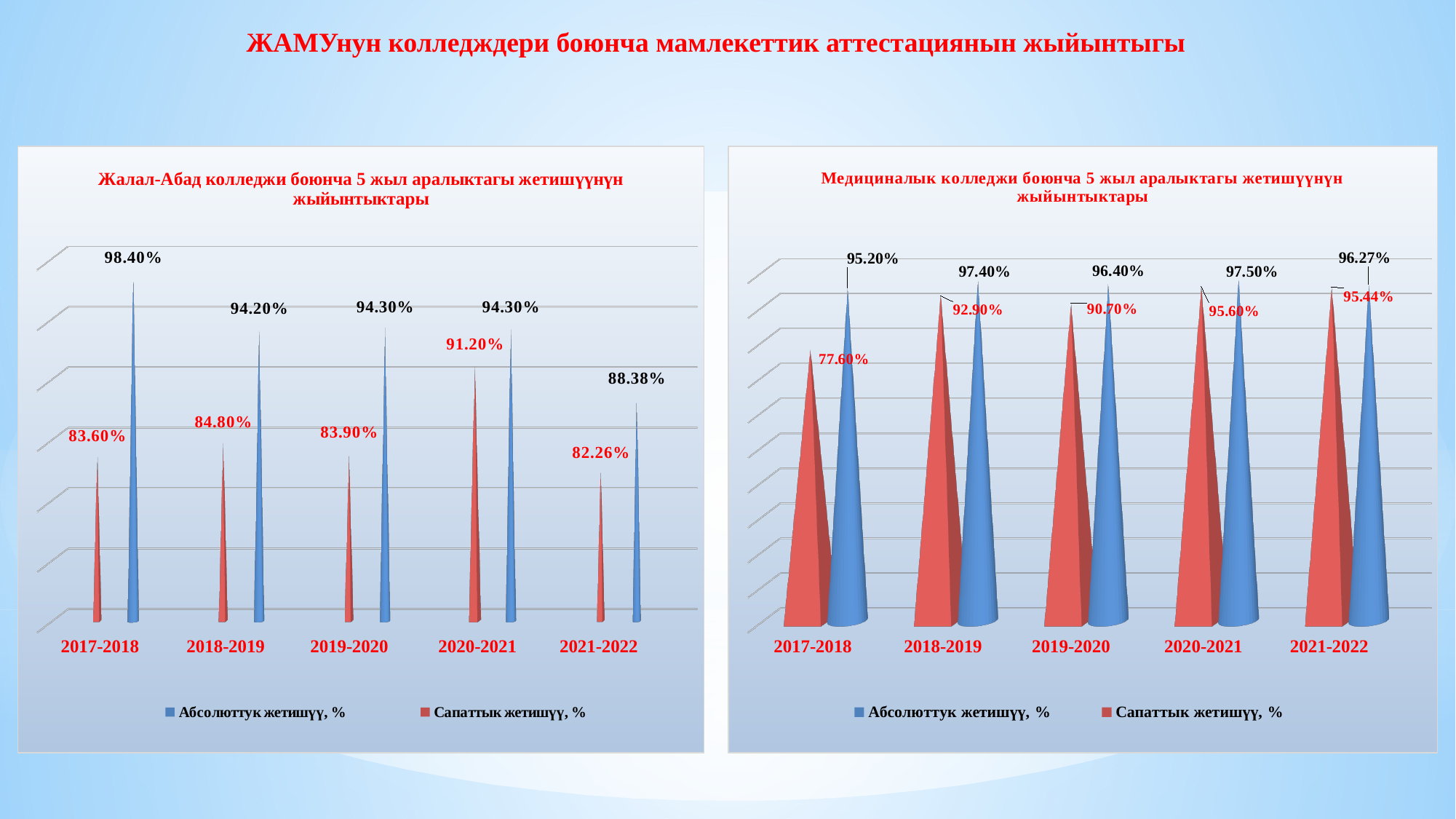
In the left chart (Жалал-Абад колледжи), what is the difference between Абсолюттук жетишүү, % and Сапаттык жетишүү, % for 2017-2018? 14.80% How many series does the legend of the right chart (Медициналык колледжи) list? 2 In the right chart (Медициналык колледжи), which year has the lowest Сапаттык жетишүү, %? 2017-2018 In the left chart (Жалал-Абад колледжи), what is the value of Абсолюттук жетишүү, % for 2017-2018? 98.40% How many year categories are shown on the x axis of the left chart (Жалал-Абад колледжи)? 5 In the right chart (Медициналык колледжи), what is the value of Сапаттык жетишүү, % for 2017-2018? 77.60% In the right chart (Медициналык колледжи), which year has the highest Абсолюттук жетишүү, %? 2020-2021 In the right chart (Медициналык колледжи), which is larger for 2018-2019: Абсолюттук жетишүү, % or Сапаттык жетишүү, %? Абсолюттук жетишүү, % In the left chart (Жалал-Абад колледжи), which year has the lowest Абсолюттук жетишүү, %? 2021-2022 In the left chart (Жалал-Абад колледжи), what is the value of Сапаттык жетишүү, % for 2020-2021? 91.20% What type of chart is the right chart (Медициналык колледжи)? Bar chart In the right chart (Медициналык колледжи), what is the value of Абсолюттук жетишүү, % for 2021-2022? 96.27%